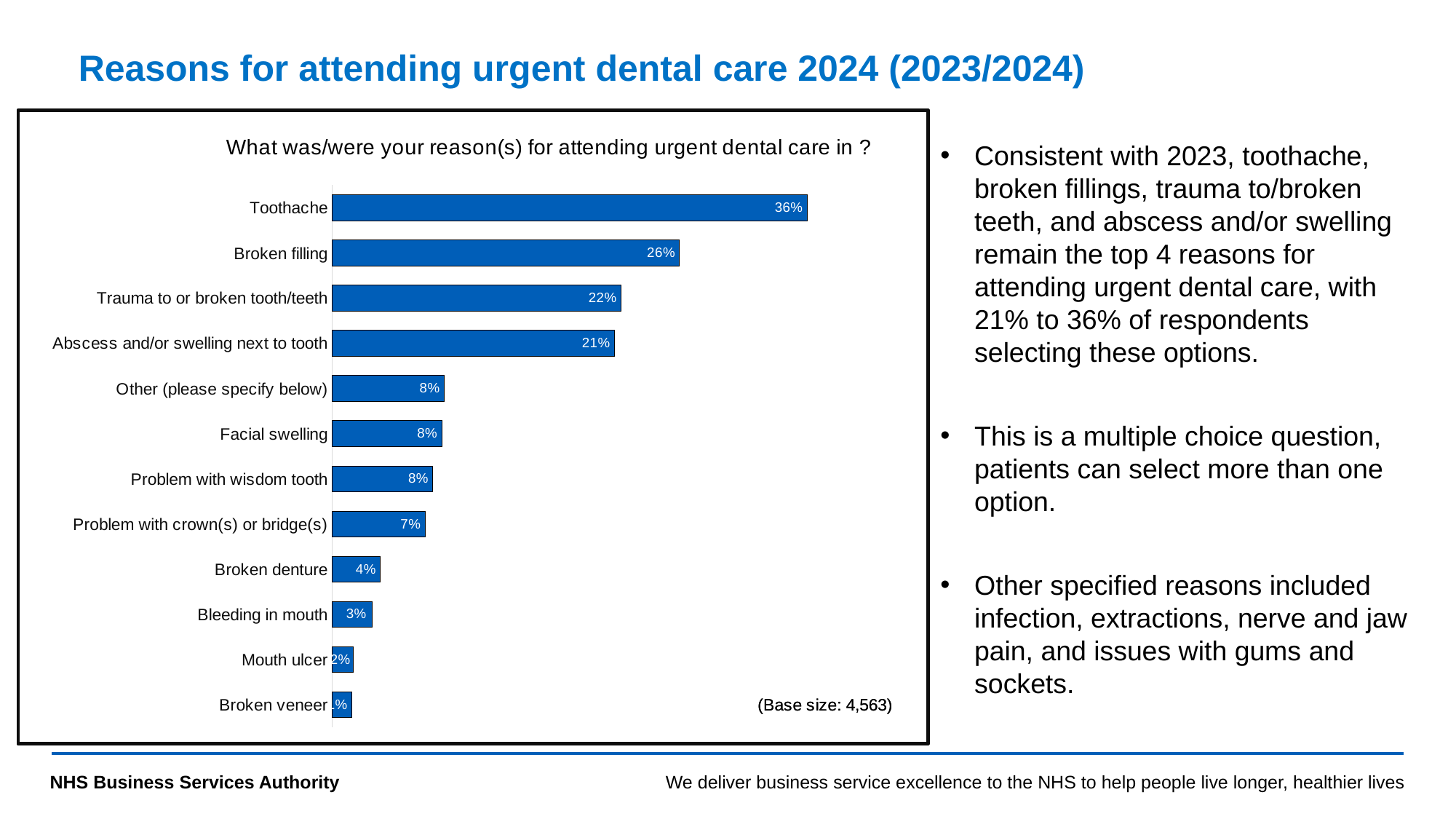
What percentage of respondents selected Toothache as a reason for attending urgent dental care? 36% What is the value shown for Abscess and/or swelling next to tooth? 21% Which reason for attending urgent dental care has the highest percentage? Toothache What is the base size stated on the chart? 4,563 What is the difference in percentage points between Toothache and Broken filling? 10 Which has a higher percentage: Bleeding in mouth or Broken denture? Broken denture What percentage of respondents selected Broken filling? 26% What percentage is shown for Broken denture? 4% What is the difference between Trauma to or broken tooth/teeth and Problem with crown(s) or bridge(s)? 15 What type of chart is used on this slide? Bar chart Which reason has the lowest percentage in the chart? Broken veneer How many reasons (categories) are shown in the chart? 12